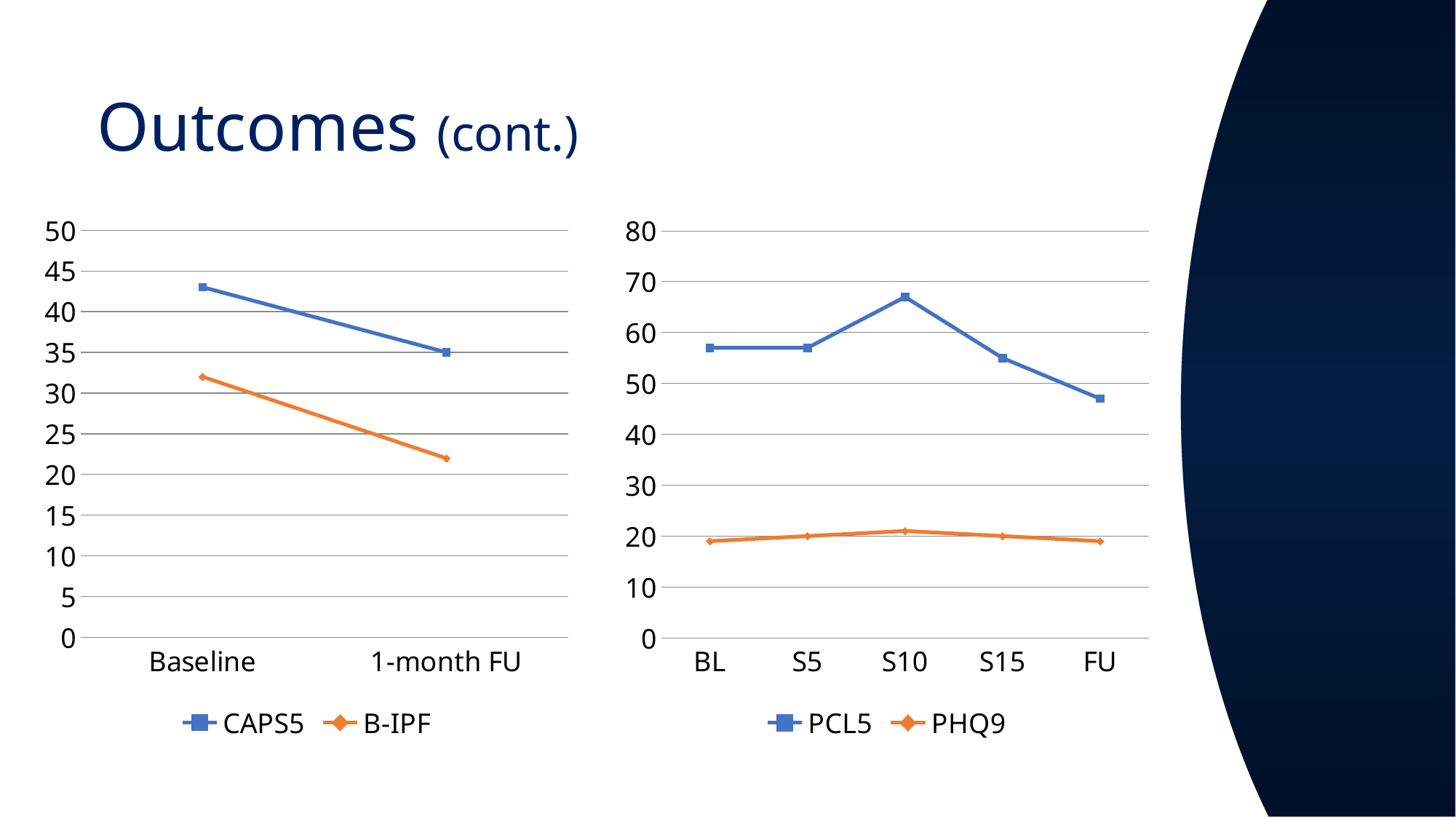
How many time points are shown on the x axis of the right chart? 5 What kind of chart is the right chart (PCL5 and PHQ9)? line chart What kind of chart is the left chart (CAPS5 and B-IPF)? line chart In the right chart, which series has the lower value at S10, PCL5 or PHQ9? PHQ9 In the left chart, is the B-IPF value at 1-month FU greater or less than 25? less In the left chart, is the CAPS5 value at Baseline greater or less than 40? greater In the left chart, which series has the higher value at Baseline, CAPS5 or B-IPF? CAPS5 In the left chart, does the CAPS5 line rise or fall from Baseline to 1-month FU? fall In the right chart, is the PCL5 value at FU greater or less than 50? less How many series does the legend of the left chart list? 2 In the right chart, at which time point is the PCL5 value highest? S10 How many time points are shown on the x axis of the left chart? 2